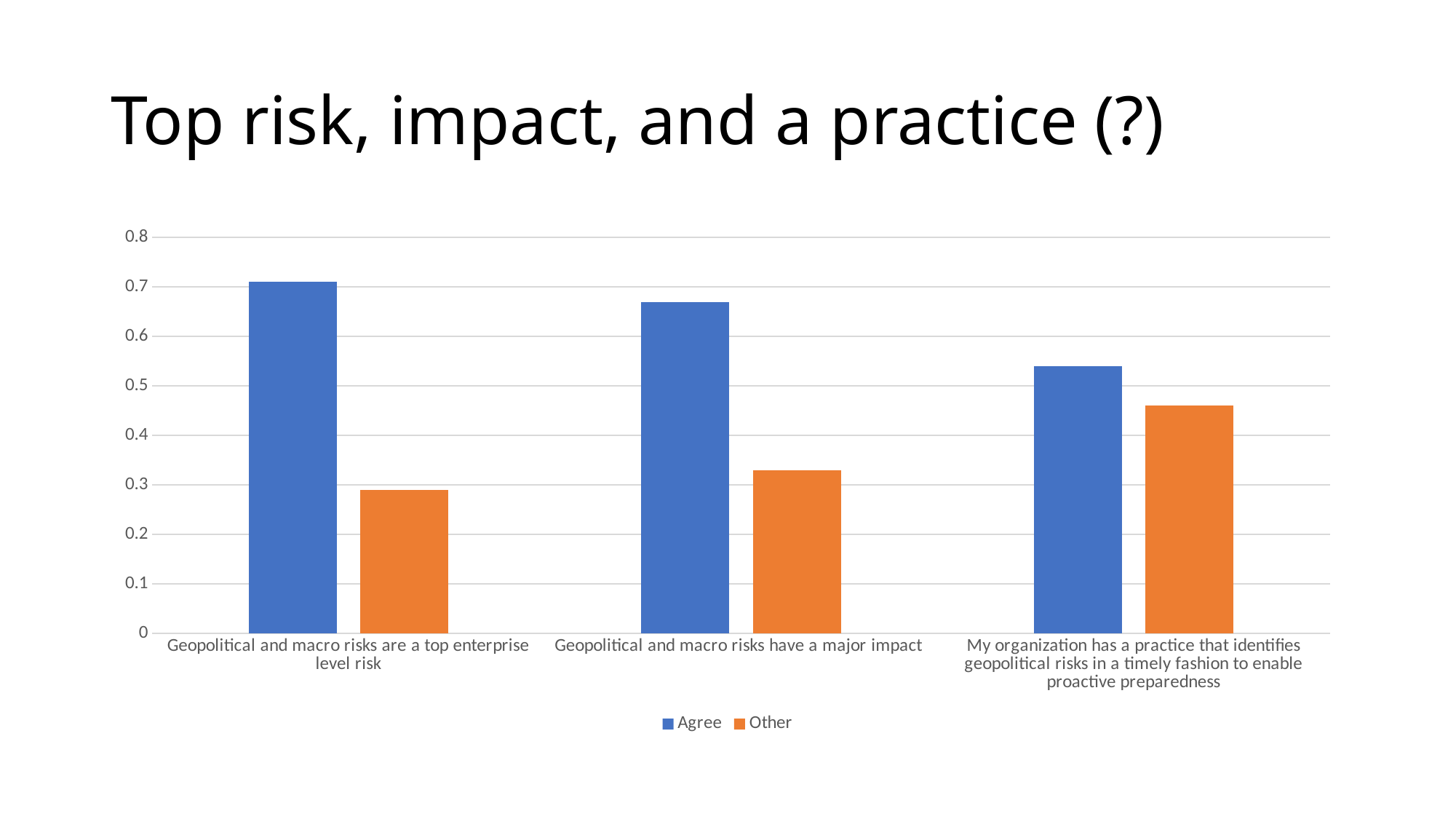
What kind of chart is shown on the slide? bar chart For "Geopolitical and macro risks have a major impact", which is larger, the Agree value or the Other value? Agree Is the Agree value for "My organization has a practice that identifies geopolitical risks in a timely fashion to enable proactive preparedness" greater or less than 0.5? greater How many series does the legend list? 2 Is the Other value for "My organization has a practice that identifies geopolitical risks in a timely fashion to enable proactive preparedness" greater or less than 0.4? greater Is the Agree value for "Geopolitical and macro risks are a top enterprise level risk" greater or less than 0.6? greater Which category has the highest Agree value? Geopolitical and macro risks are a top enterprise level risk Do the Agree values rise or fall moving from left to right across the categories? fall What colour are the Other bars? orange Which category has the lowest Other value? Geopolitical and macro risks are a top enterprise level risk How many categories are shown on the x axis? 3